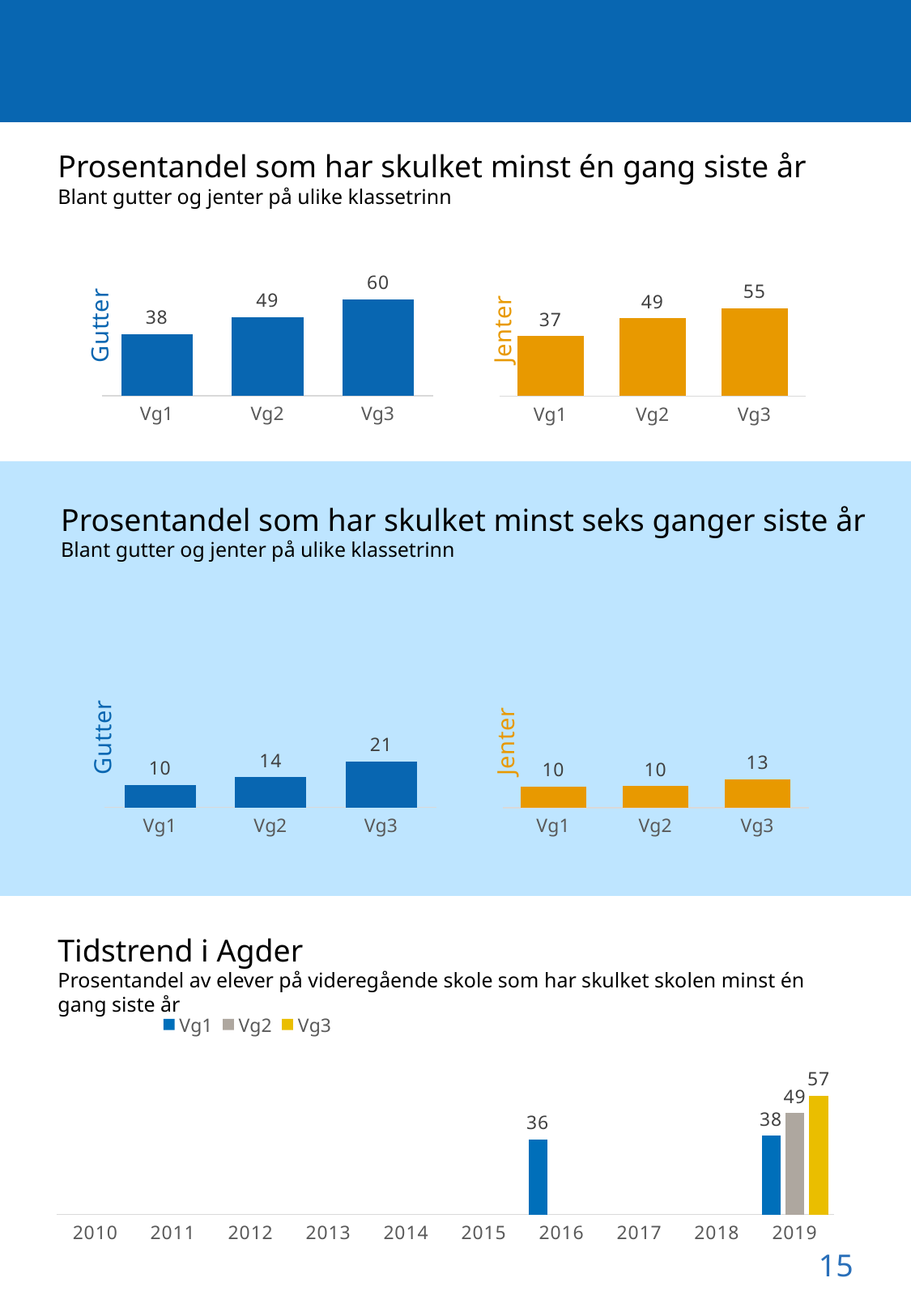
In the middle chart 'Prosentandel som har skulket minst seks ganger siste år', what is the value for Gutter at Vg3? 21 In the top chart 'Prosentandel som har skulket minst én gang siste år', which class level has the highest value among Gutter? Vg3 In the bottom chart 'Tidstrend i Agder', what is the value for Vg1 in 2016? 36 In the top chart 'Prosentandel som har skulket minst én gang siste år', do the Gutter values rise or fall from Vg1 to Vg3? rise In the middle chart 'Prosentandel som har skulket minst seks ganger siste år', which is larger at Vg2: Gutter or Jenter? Gutter In the middle chart 'Prosentandel som har skulket minst seks ganger siste år', what is the value for Jenter at Vg2? 10 In the bottom chart 'Tidstrend i Agder', how many series does the legend list? 3 In the top chart 'Prosentandel som har skulket minst én gang siste år', what is the difference between Gutter and Jenter at Vg3? 5 What kind of chart is the bottom chart 'Tidstrend i Agder'? bar chart In the bottom chart 'Tidstrend i Agder', what is the value for Vg3 in 2019? 57 In the top chart 'Prosentandel som har skulket minst én gang siste år', what is the value for Jenter at Vg1? 37 In the top chart 'Prosentandel som har skulket minst én gang siste år', what is the value for Gutter at Vg3? 60